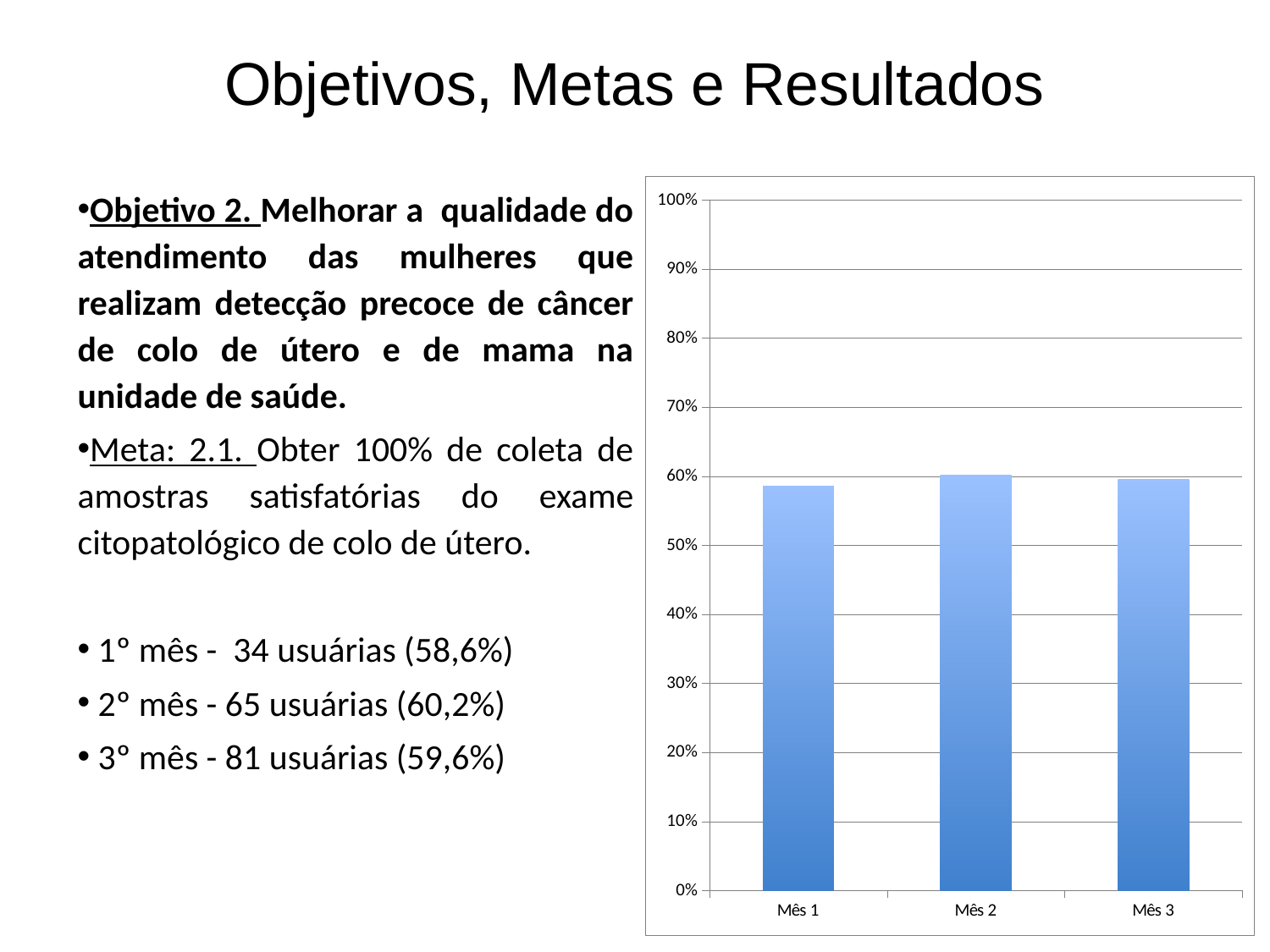
Is the value for Mês 2 greater or less than 70%? less Is the value for Mês 3 greater or less than 50%? greater How many categories (months) are plotted on the chart? 3 Is the value for Mês 1 greater or less than 80%? less What kind of chart is shown on the slide? bar chart According to the slide, what percentage corresponds to Mês 3 (3º mês)? 59,6% According to the slide, what percentage corresponds to Mês 2 (2º mês)? 60,2% What are the category labels on the x axis of the chart? Mês 1, Mês 2, Mês 3 What is the highest value shown on the y axis of the chart? 100% According to the slide, what percentage corresponds to Mês 1 (1º mês)? 58,6%